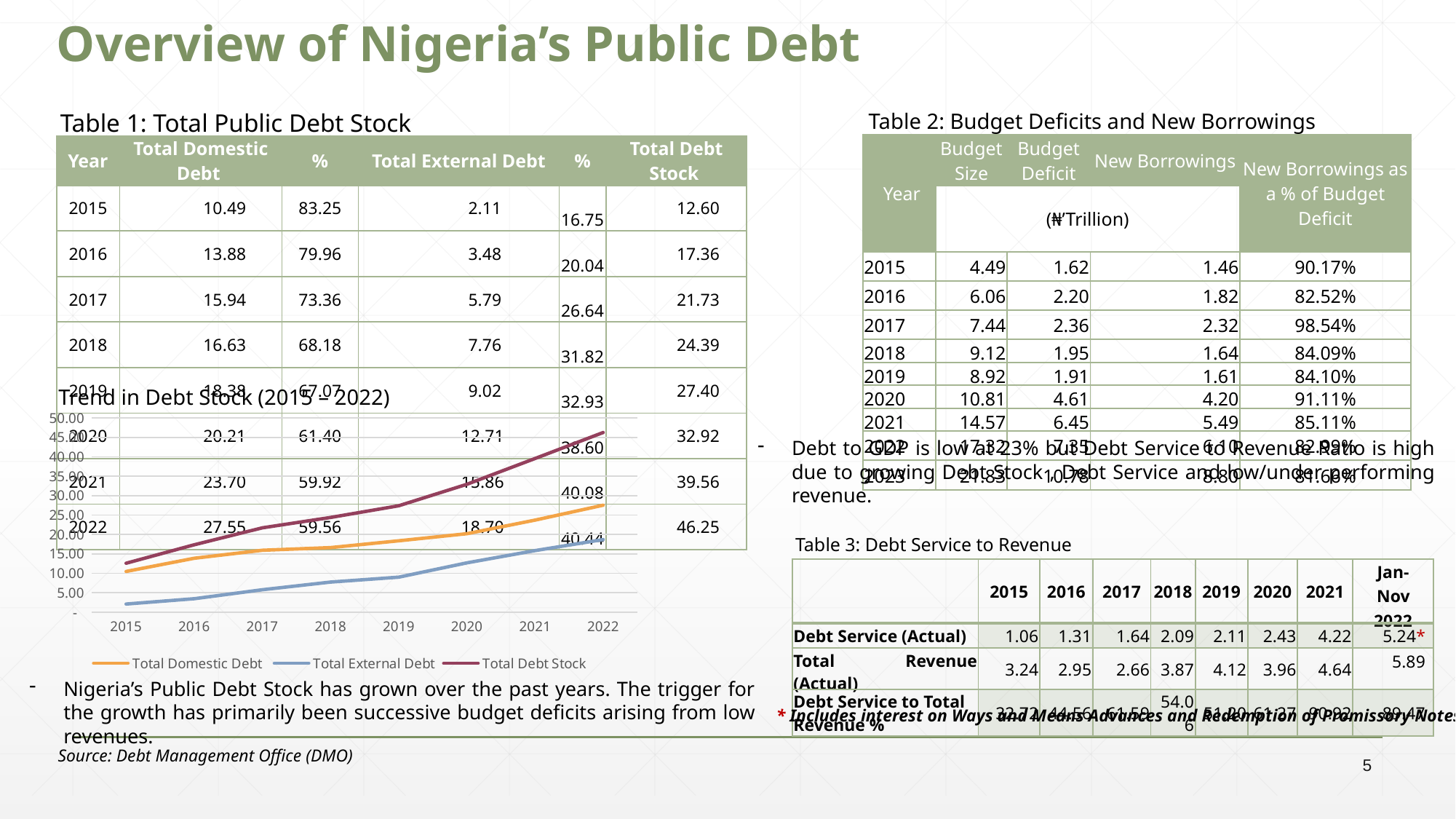
How many years are plotted along the x axis of the 'Trend in Debt Stock (2015 – 2022)' chart? 8 In the 'Trend in Debt Stock (2015 – 2022)' chart, is the Total External Debt value for 2015 greater or less than 5.00? less In the 'Trend in Debt Stock (2015 – 2022)' chart, what colour is the Total External Debt line? blue What is the title of the line chart on the slide? Trend in Debt Stock (2015 – 2022) In the 'Trend in Debt Stock (2015 – 2022)' chart, which series has the lowest values across all years? Total External Debt In the 'Trend in Debt Stock (2015 – 2022)' chart, does the Total Debt Stock line rise or fall from 2015 to 2022? rise What kind of chart is shown under the heading 'Trend in Debt Stock (2015 – 2022)'? line chart How many series does the legend of the 'Trend in Debt Stock (2015 – 2022)' chart list? 3 In the 'Trend in Debt Stock (2015 – 2022)' chart, in which year does Total Debt Stock reach its highest value? 2022 In the 'Trend in Debt Stock (2015 – 2022)' chart, which is larger in 2020: Total Domestic Debt or Total External Debt? Total Domestic Debt In the 'Trend in Debt Stock (2015 – 2022)' chart, is the Total Debt Stock value for 2022 greater or less than 40.00? greater In the 'Trend in Debt Stock (2015 – 2022)' chart, is the Total Domestic Debt value for 2022 greater or less than 25.00? greater